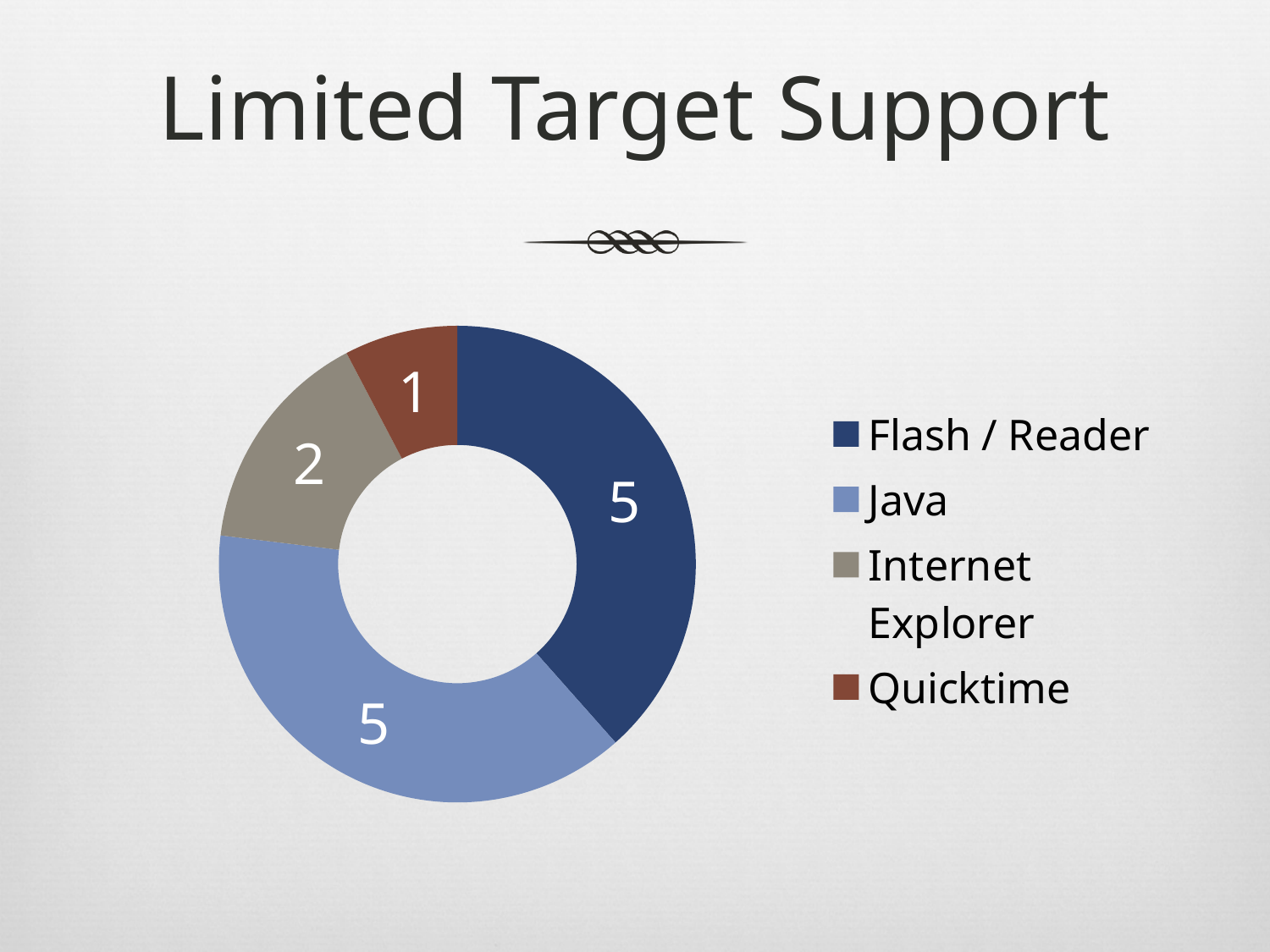
Which is larger, the value for Internet Explorer or the value for Quicktime? Internet Explorer What is the value for Java? 5 What is the difference between the values for Java and Internet Explorer? 3 What is the title of the slide? Limited Target Support What is the value for Flash / Reader? 5 What is the value for Internet Explorer? 2 Which category has the lowest value? Quicktime What is the difference between the values for Flash / Reader and Quicktime? 4 What is the total of all the values shown in the chart? 13 How many categories does the chart show? 4 What is the value for Quicktime? 1 What kind of chart is shown on the slide? Doughnut (pie) chart